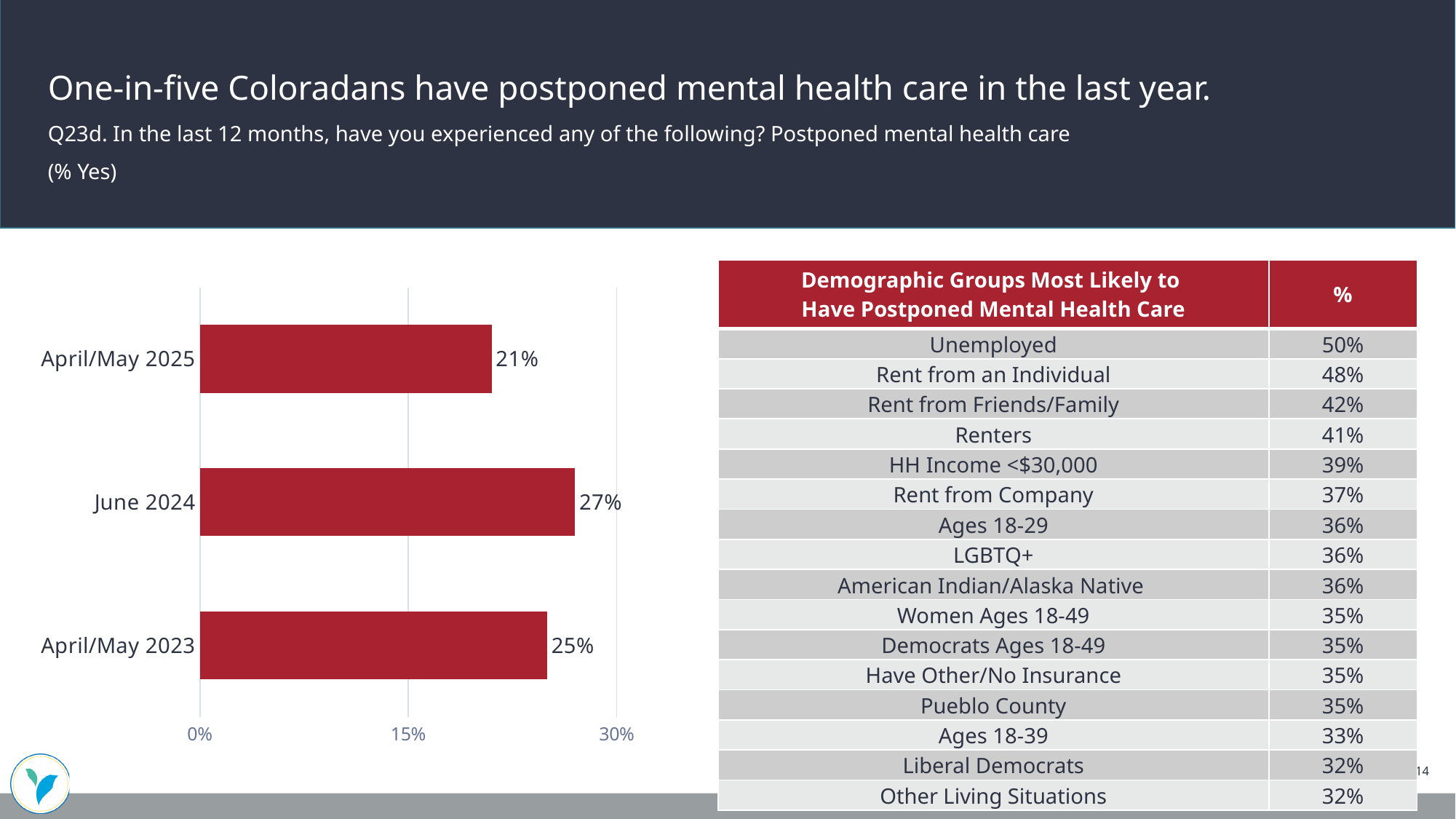
What kind of chart is shown on the slide? bar chart How many periods are shown in the chart? 3 What is the value for April/May 2025? 21% What is the value for April/May 2023? 25% Which is larger, the value for April/May 2023 or the value for April/May 2025? April/May 2023 What is the highest value shown on the chart's axis? 30% What colour are the bars in the chart? red Which period has the highest value? June 2024 What is the value for June 2024? 27% Is the value for June 2024 greater or less than 15%? greater Which period has the lowest value? April/May 2025 What is the difference between the June 2024 value and the April/May 2025 value? 6%